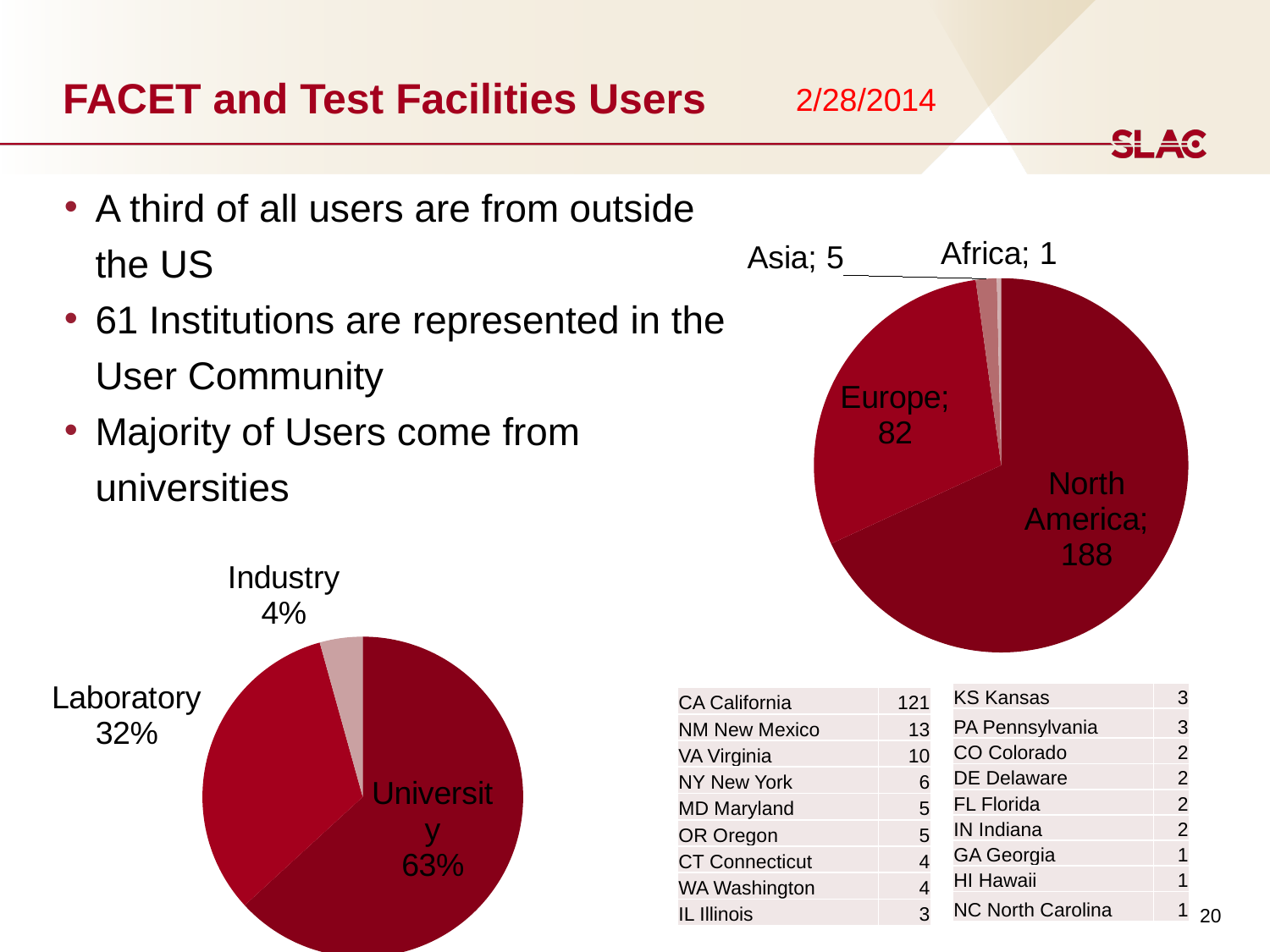
In the pie chart on the right showing users by region, what is the total of all slices? 276 In the pie chart at the lower left showing users by institution type, which category has the largest share? University What kind of chart is used at the lower left of the slide to show users by institution type? Pie chart In the pie chart at the lower left showing users by institution type, what share is Laboratory? 32% In the pie chart on the right showing users by region, what is the value for Europe? 82 In the pie chart on the right showing users by region, what is the value for North America? 188 In the pie chart on the right showing users by region, how many regions are shown? 4 In the pie chart on the right showing users by region, which region has the smallest value? Africa In the pie chart on the right showing users by region, which is larger, Asia or Africa? Asia In the pie chart on the right showing users by region, what is the difference between North America and Europe? 106 In the pie chart at the lower left showing users by institution type, what share is Industry? 4% In the pie chart on the right showing users by region, which region has the largest value? North America